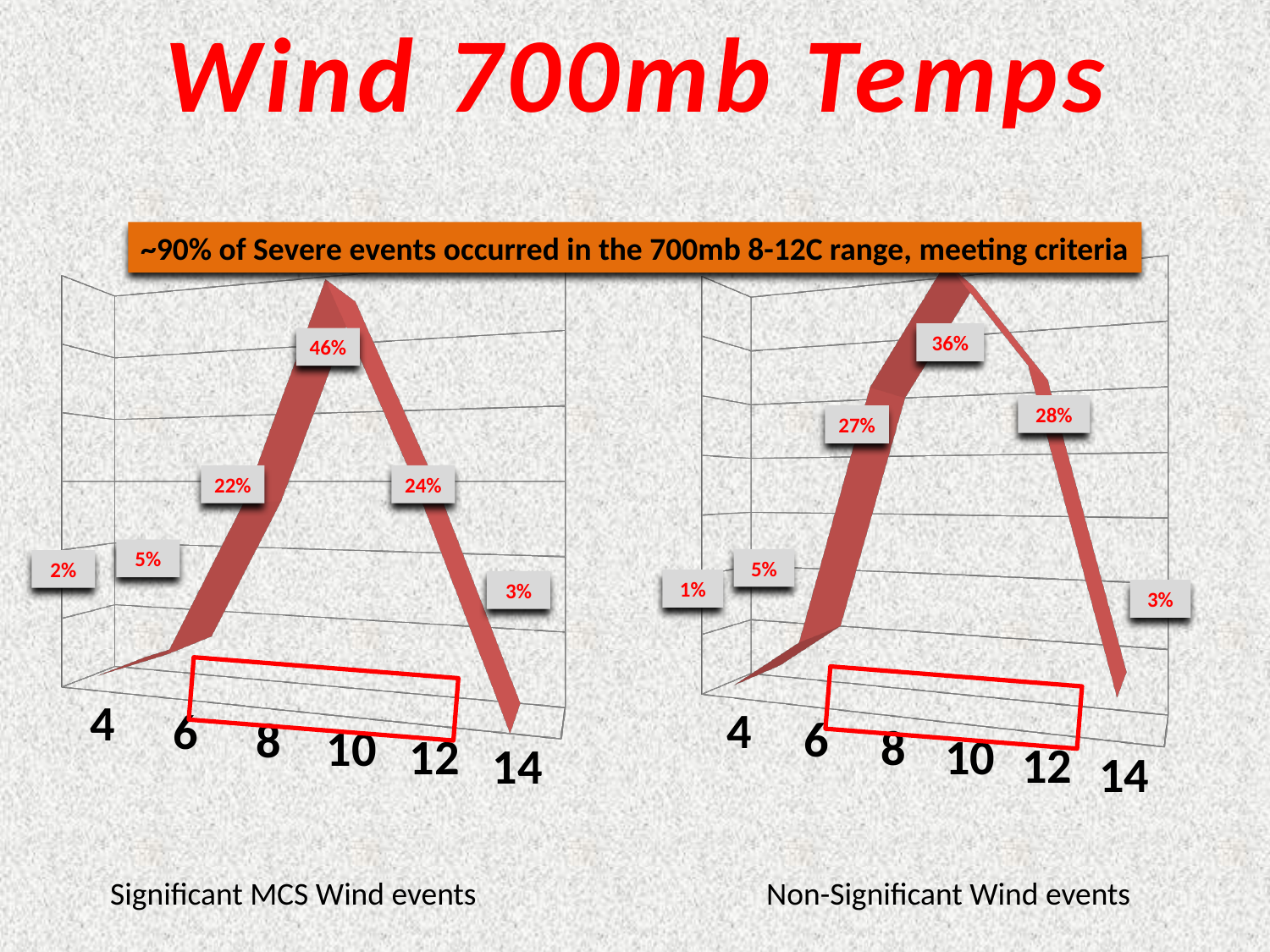
In the Significant MCS Wind events chart, what is the difference between the values at 10 and 12? 22% In the Non-Significant Wind events chart, what is the difference between the values at 10 and 8? 9% In the Non-Significant Wind events chart, what is the value at 12? 28% What is the title of the slide? Wind 700mb Temps In the Non-Significant Wind events chart, which category has the lowest value? 4 How many categories are shown on the x axis of the Significant MCS Wind events chart? 6 Which is larger: the value at 8 in the Significant MCS Wind events chart or the value at 8 in the Non-Significant Wind events chart? Non-Significant Wind events What kind of chart is the Non-Significant Wind events chart? Line chart In the Significant MCS Wind events chart, which category has the highest value? 10 In the Significant MCS Wind events chart, what is the value at 10? 46% In the Non-Significant Wind events chart, what is the value at 8? 27%